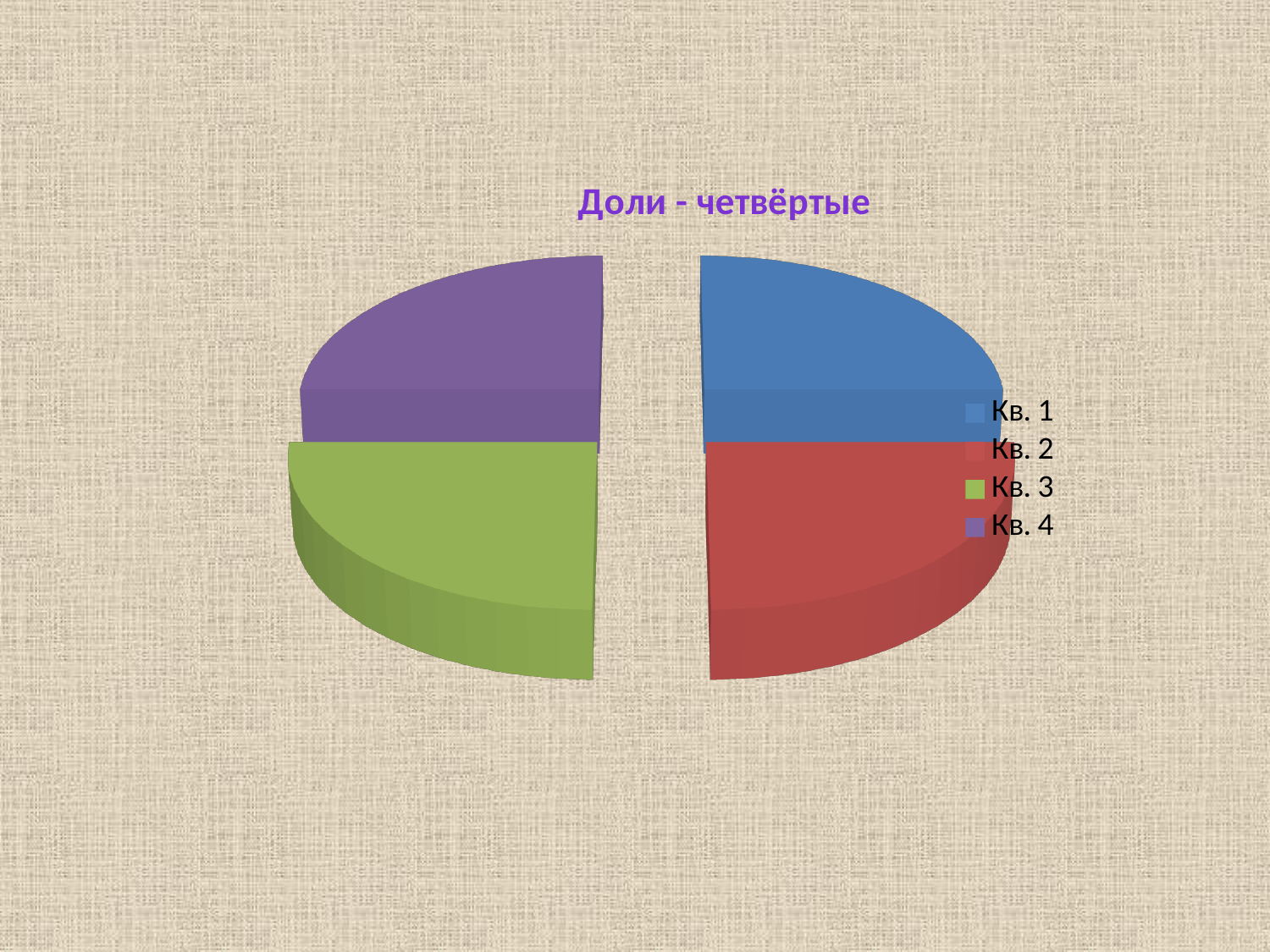
Which colour represents Кв. 1 in the pie chart? blue How many entries does the legend list? 4 What is the title of the chart? Доли - четвёртые Which legend entry is shown in purple? Кв. 4 How many slices does the pie chart have? 4 Which legend entry is shown in red? Кв. 2 What kind of chart is shown on the slide? pie chart Which legend entry is shown in green? Кв. 3